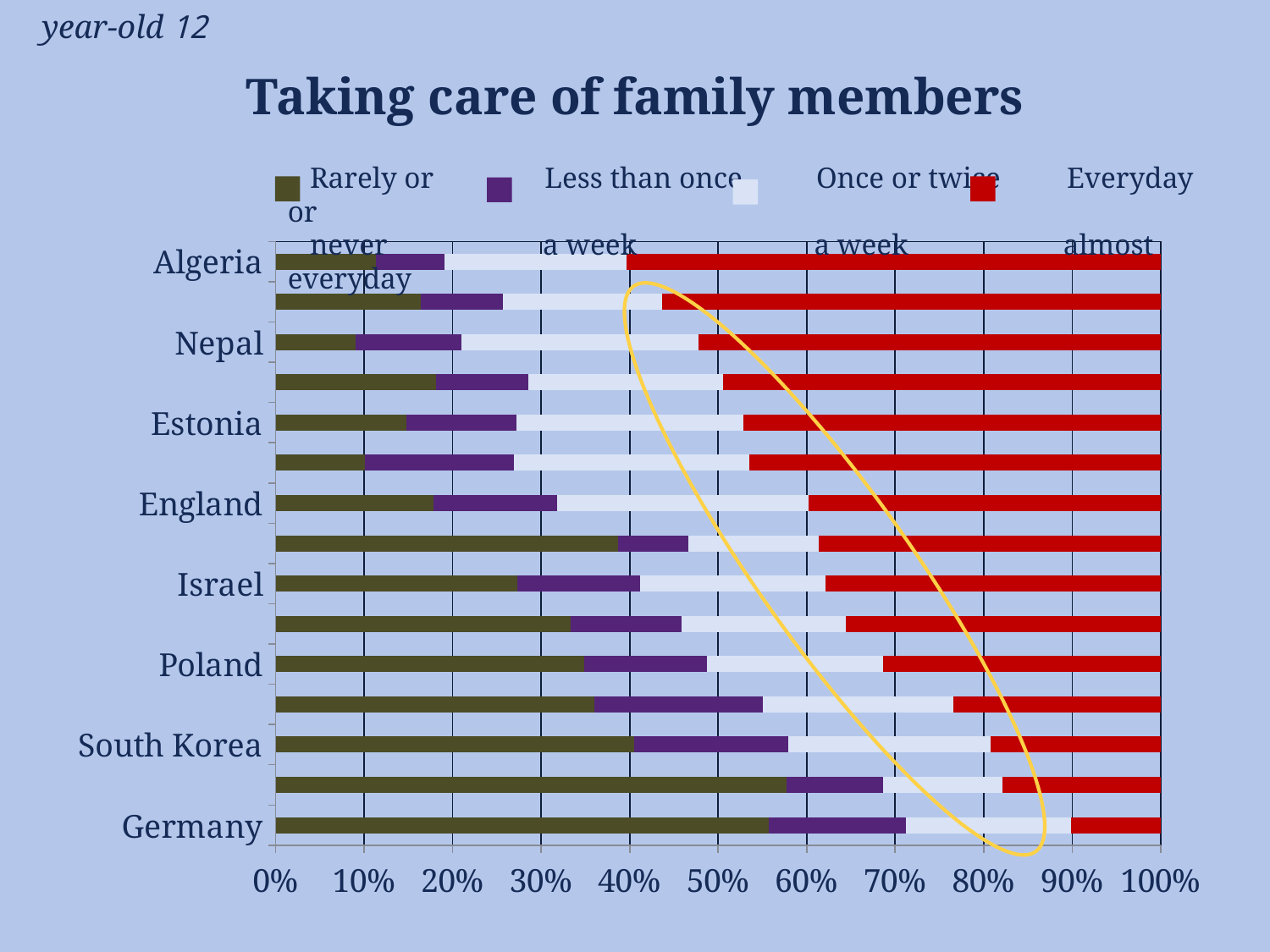
How many series does the legend list? 4 Is the 'Rarely or never' share for Algeria greater or less than 20%? less Is the 'Everyday or almost everyday' share for Germany greater or less than 20%? less Is the 'Rarely or never' share for Germany greater or less than 50%? greater Which country has the smallest 'Everyday or almost everyday' share? Germany Which has the larger 'Rarely or never' share, Algeria or Germany? Germany What is the title of the chart? Taking care of family members What kind of chart is shown on the slide? Stacked bar chart Which country has the largest 'Everyday or almost everyday' share? Algeria Which colour represents the 'Everyday or almost everyday' series? Red